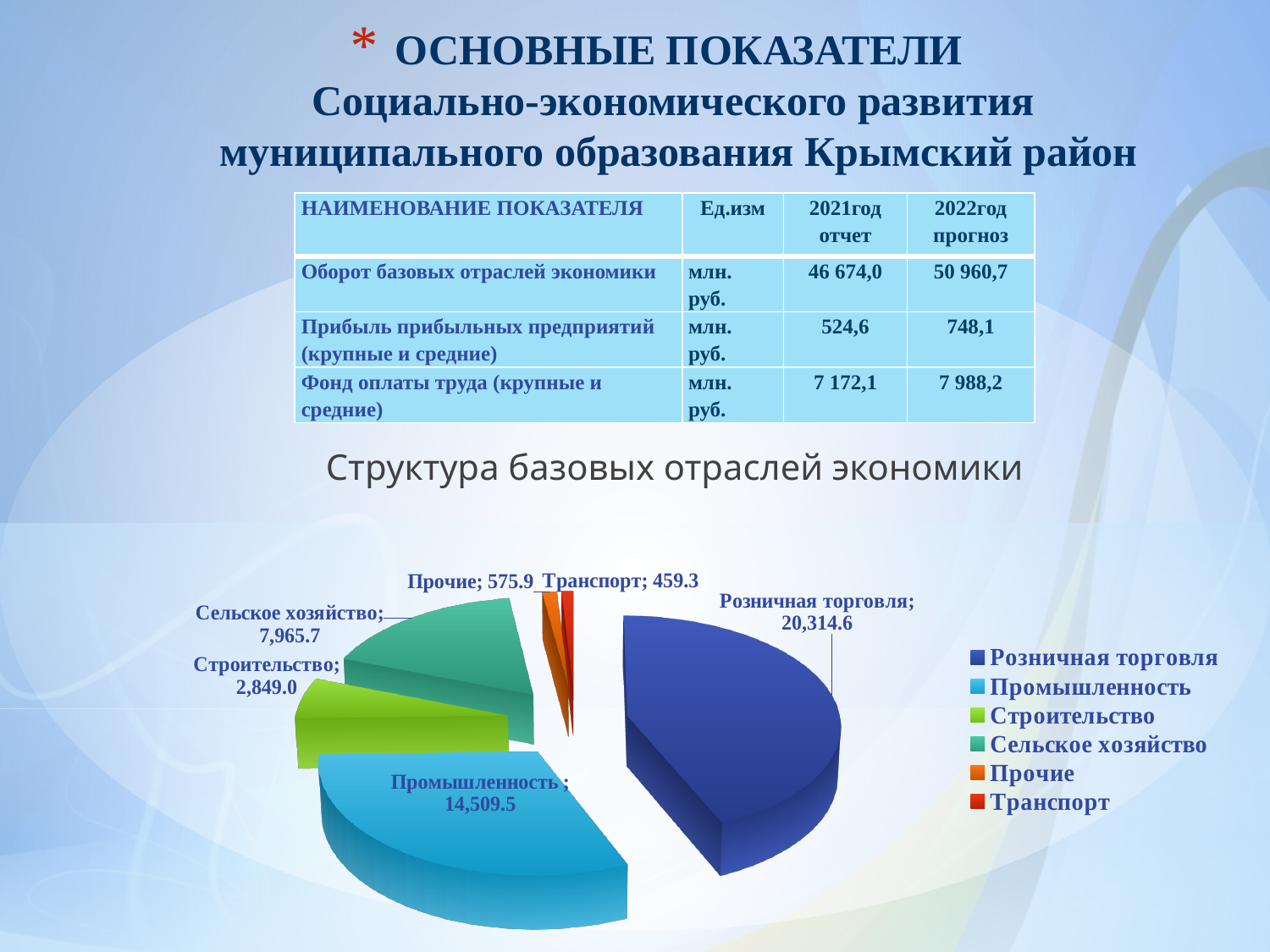
What is the difference between the Розничная торговля and Промышленность values in the pie chart? 5,805.1 What is the value of the Транспорт slice in the pie chart? 459.3 How many slices does the pie chart have? 6 What is the value of the Сельское хозяйство slice in the pie chart? 7,965.7 How many entries does the legend of the pie chart list? 6 What is the difference between the Прочие and Транспорт values in the pie chart? 116.6 Which category has the smallest slice in the pie chart? Транспорт Which category has the largest slice in the pie chart? Розничная торговля In the pie chart, which is larger: Сельское хозяйство or Строительство? Сельское хозяйство What is the value of the Розничная торговля slice in the pie chart? 20,314.6 What type of chart is shown under the heading "Структура базовых отраслей экономики"? pie chart What is the value of the Промышленность slice in the pie chart? 14,509.5